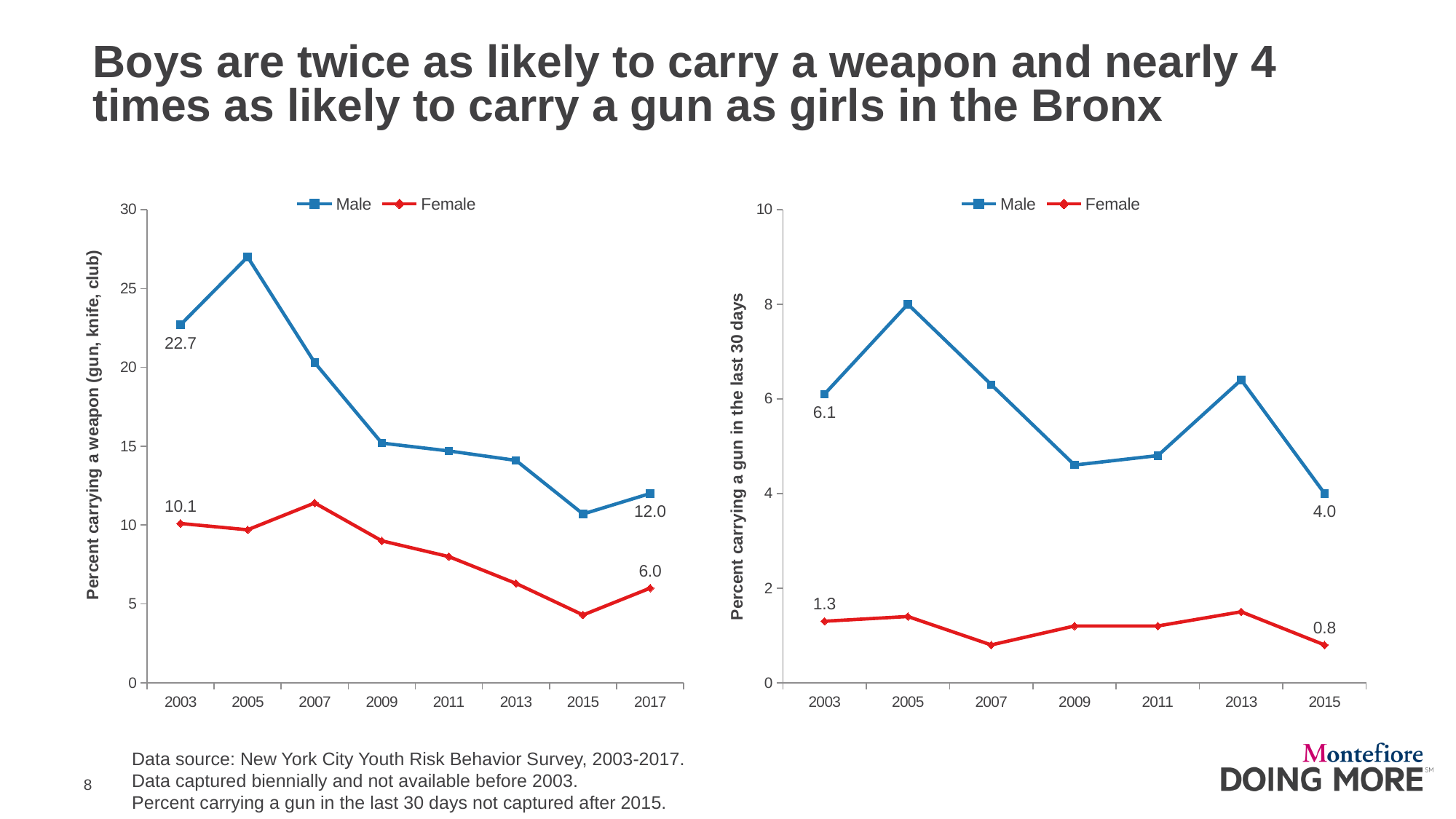
On the right chart (percent carrying a gun), what is the Female value for 2003? 1.3 What kind of chart is the right chart (percent carrying a gun)? Line chart On the right chart (percent carrying a gun), is the Male value for 2009 greater or less than 5? less On the left chart (percent carrying a weapon), what is the difference between the Male and Female values in 2003? 12.6 On the left chart (percent carrying a weapon), how many series does the legend list? 2 On the right chart (percent carrying a gun), what is the difference between the Male and Female values in 2003? 4.8 On the left chart (percent carrying a weapon), what is the Female value for 2017? 6.0 On the left chart (percent carrying a weapon), what is the Male value for 2003? 22.7 On the right chart (percent carrying a gun), how many years are shown on the x axis? 7 On the right chart (percent carrying a gun), what is the Male value for 2015? 4.0 On the left chart (percent carrying a weapon), how many years are shown on the x axis? 8 On the left chart (percent carrying a weapon), in which year is the Male value highest? 2005